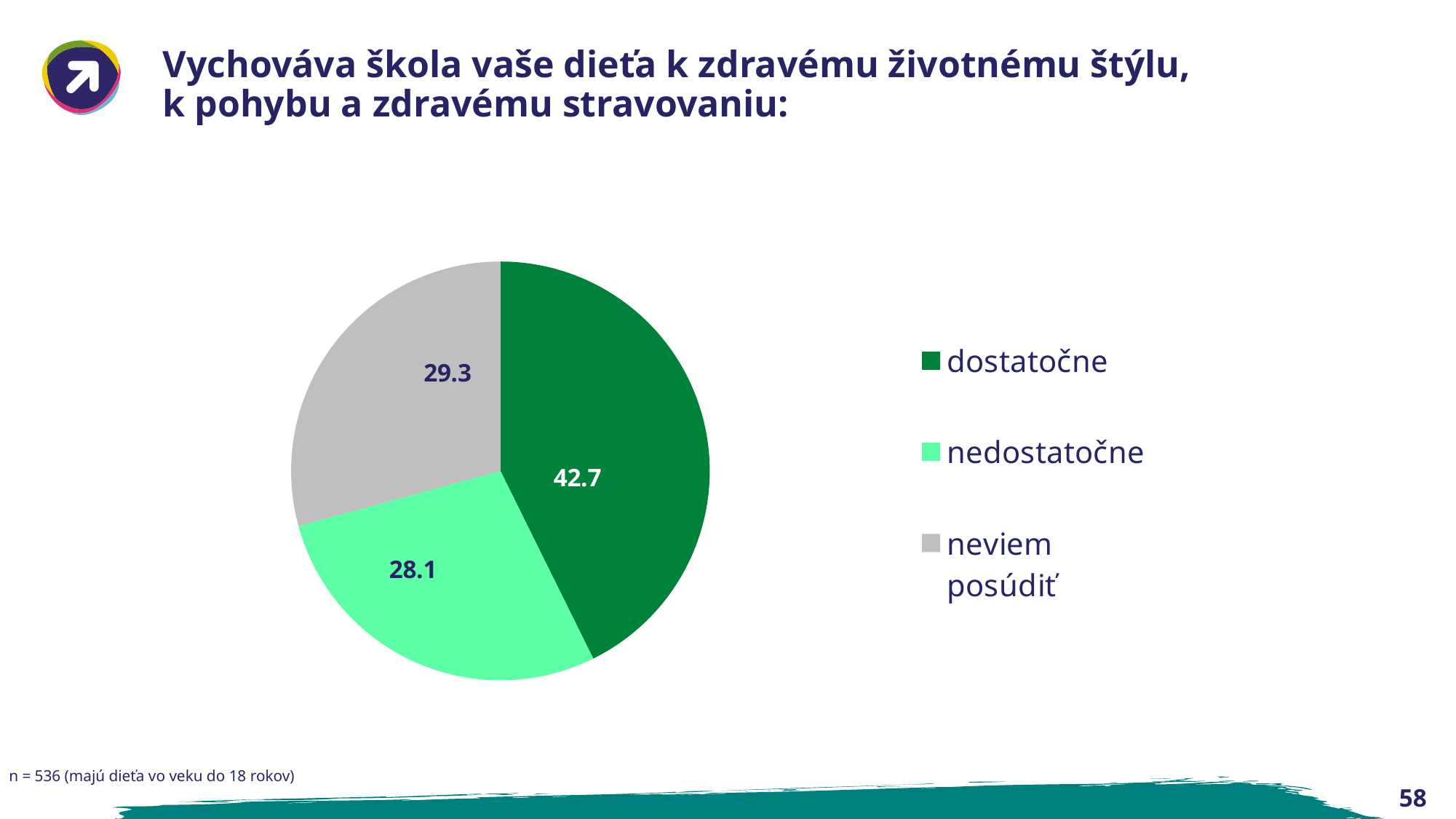
What value is shown for the "nedostatočne" slice? 28.1 What sample size is stated in the note at the bottom of the slide? n = 536 What is the difference between the values for "neviem posúdiť" and "nedostatočne"? 1.2 Which category has the largest slice of the pie? dostatočne Which is larger, the value for "dostatočne" or the value for "neviem posúdiť"? dostatočne What colour is the "neviem posúdiť" slice? grey What is the difference between the values for "dostatočne" and "nedostatočne"? 14.6 What value is shown for the "neviem posúdiť" slice? 29.3 What kind of chart is shown on the slide? pie chart Which category has the smallest slice of the pie? nedostatočne How many slices does the pie chart have? 3 What value is shown for the "dostatočne" slice? 42.7